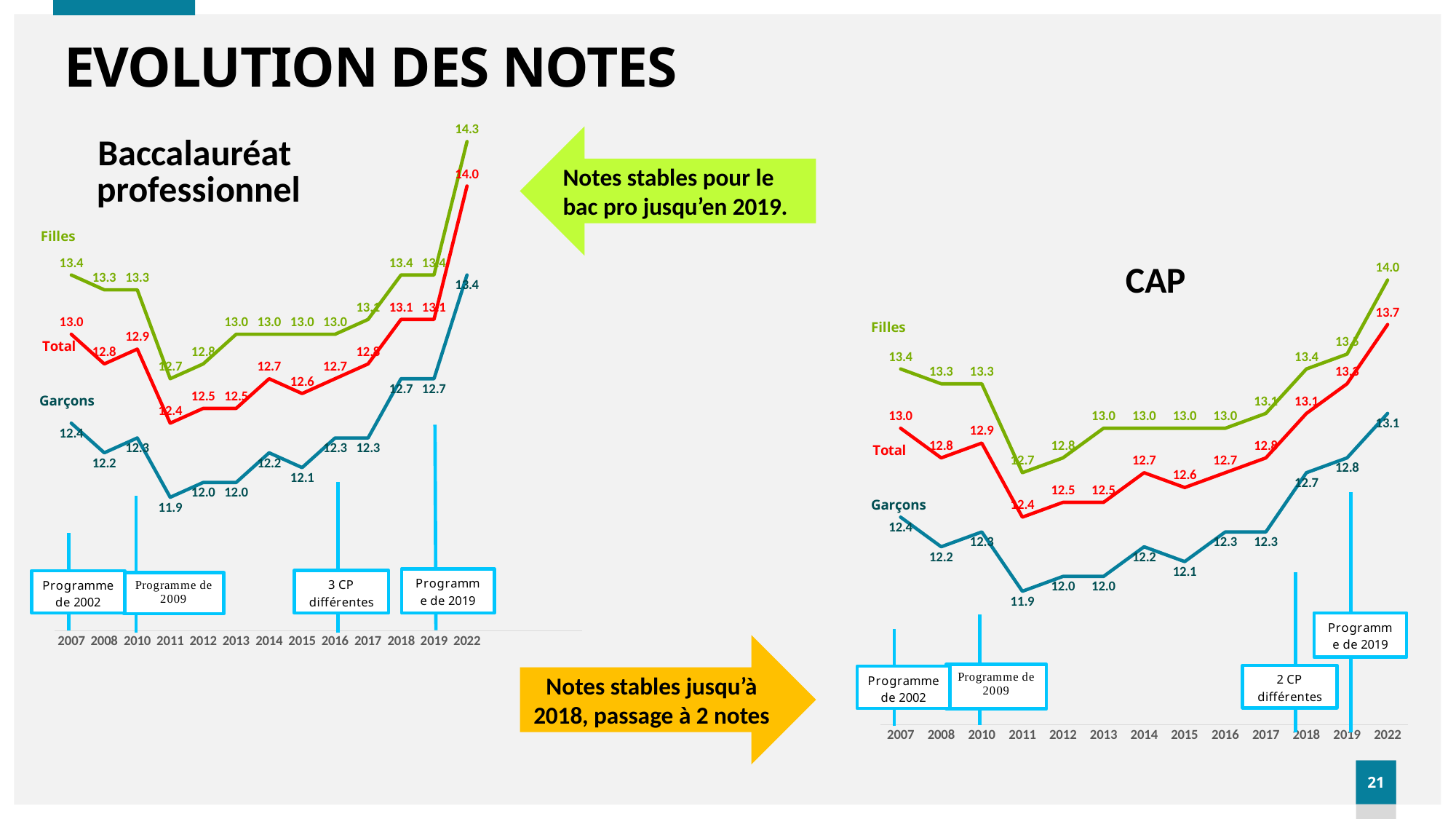
In the Baccalauréat professionnel chart, what is the difference between Filles and Garçons in 2022? 0.9 In the CAP chart, what is the difference between Total in 2007 and Total in 2011? 0.6 In the CAP chart, what is the value for Total in 2022? 13.7 How many years are shown on the x axis of the CAP chart? 13 In the CAP chart, what is the value for Garçons in 2018? 12.7 In the Baccalauréat professionnel chart, which is larger: Total in 2018 or Total in 2014? Total in 2018 How many series does the Baccalauréat professionnel chart show? 3 What kind of chart is the CAP chart? Line chart In the Baccalauréat professionnel chart, in which year is the Garçons series lowest? 2011 In the Baccalauréat professionnel chart, what is the value for Filles in 2022? 14.3 In the Baccalauréat professionnel chart, what is the value for Garçons in 2011? 11.9 In the CAP chart, in which year is the Filles series highest? 2022